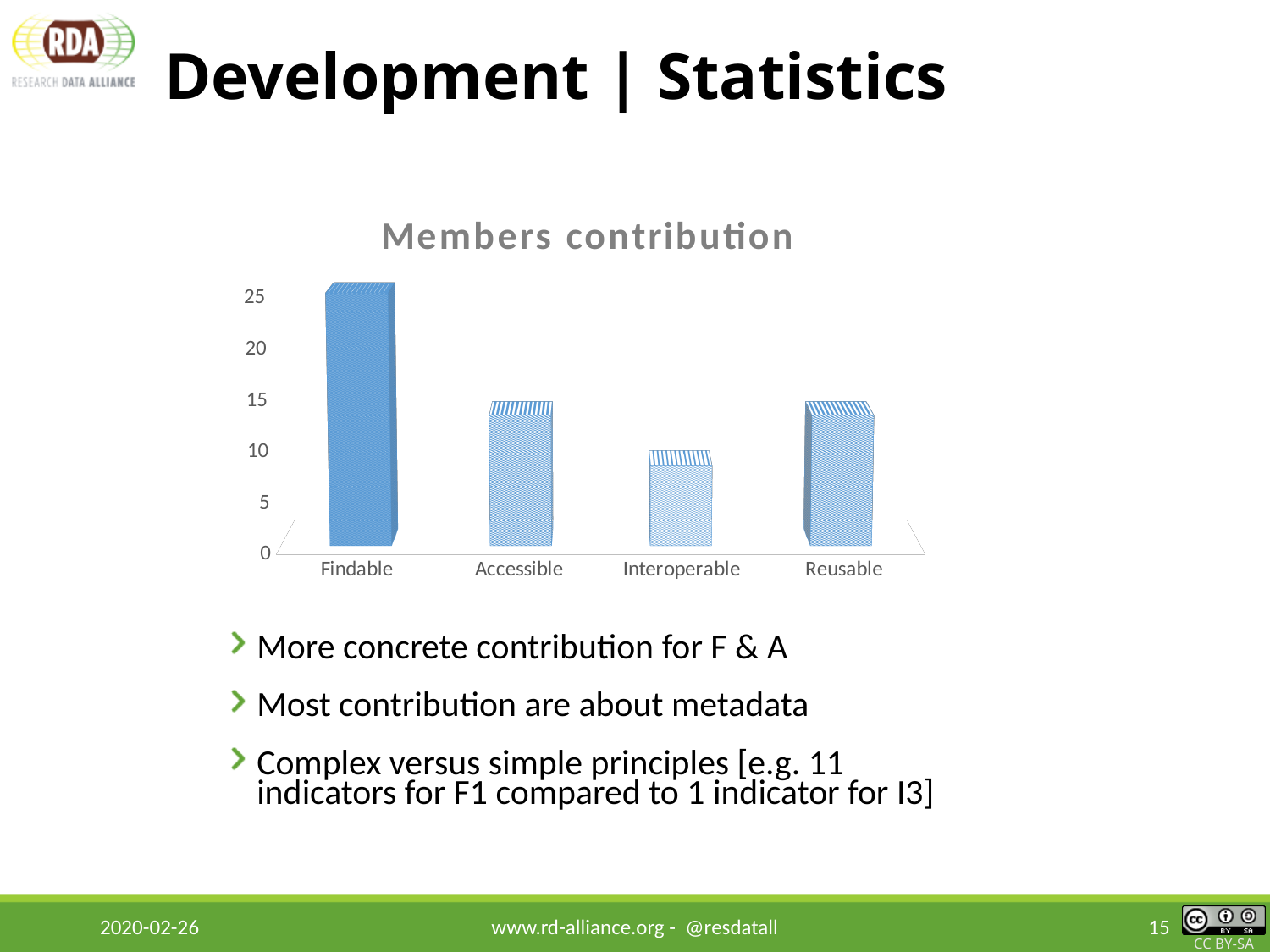
Which is larger, the value for Accessible or the value for Interoperable? Accessible What kind of chart is shown on the slide? bar chart Which is larger, the value for Findable or the value for Accessible? Findable Is the value for Reusable greater or less than 20? less Is the value for Findable greater or less than 20? greater What is the title of the chart? Members contribution Which category has the lowest value in the Members contribution chart? Interoperable Is the value for Interoperable greater or less than 5? greater How many categories are shown on the x axis of the chart? 4 Which category has the highest value in the Members contribution chart? Findable What is the highest tick value shown on the vertical axis? 25